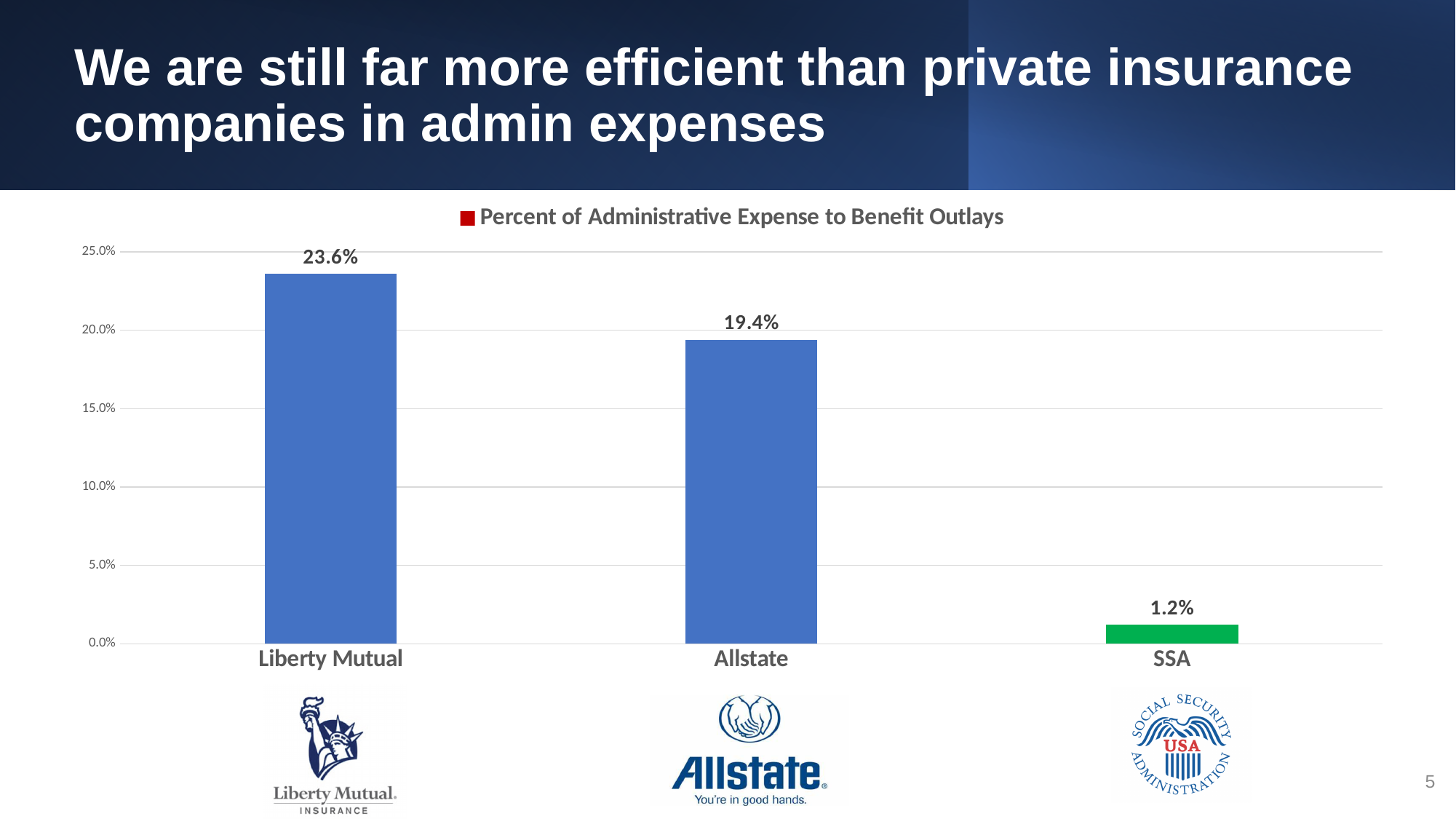
What kind of chart is shown on the slide? bar chart Which is larger, the value for Allstate or the value for SSA? Allstate How many categories are shown on the chart? 3 What is the difference between the values for Liberty Mutual and Allstate? 4.2% What is the value for Liberty Mutual? 23.6% Which category has the highest value? Liberty Mutual What series name does the chart legend show? Percent of Administrative Expense to Benefit Outlays What is the value for SSA? 1.2% Is the value for Allstate greater or less than 20.0%? less What is the value for Allstate? 19.4% What is the difference between the values for Allstate and SSA? 18.2% Which category has the lowest value? SSA